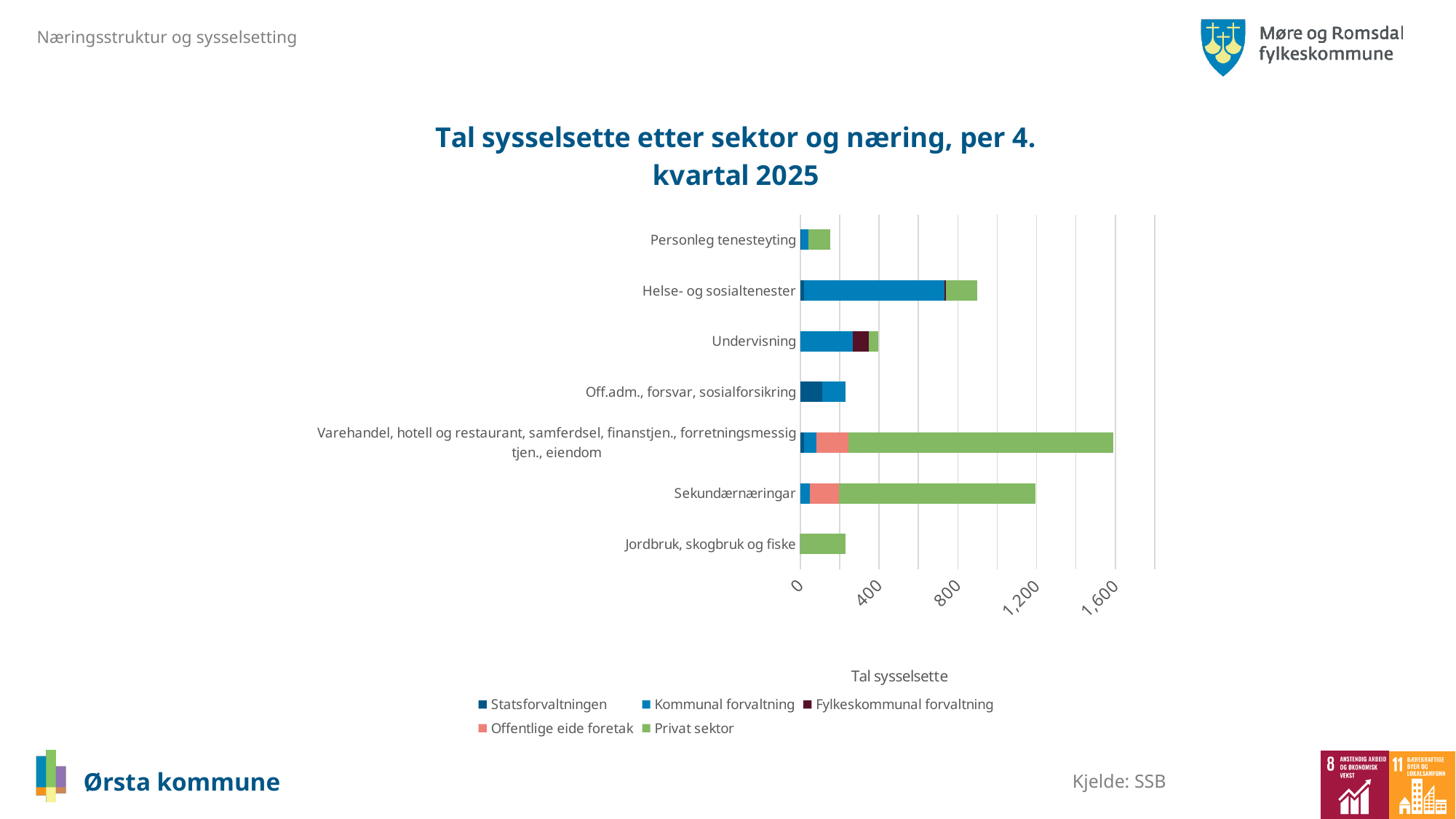
How many series does the legend list? 5 Which series is shown in green in the legend? Privat sektor What is the title of the chart? Tal sysselsette etter sektor og næring, per 4. kvartal 2025 What kind of chart is shown on the slide? Stacked bar chart Is the total value for Off.adm., forsvar, sosialforsikring greater or less than 400? less How many categories (næringar) are plotted on the chart? 7 Which has a larger total, Helse- og sosialtenester or Undervisning? Helse- og sosialtenester Is the total value for Jordbruk, skogbruk og fiske greater or less than 400? less Which category has the longest total bar? Varehandel, hotell og restaurant, samferdsel, finanstjen., forretningsmessig tjen., eiendom Is the total value for Helse- og sosialtenester greater or less than 800? greater Which has a larger total, Sekundærnæringar or Helse- og sosialtenester? Sekundærnæringar Which category has the shortest total bar? Personleg tenesteyting